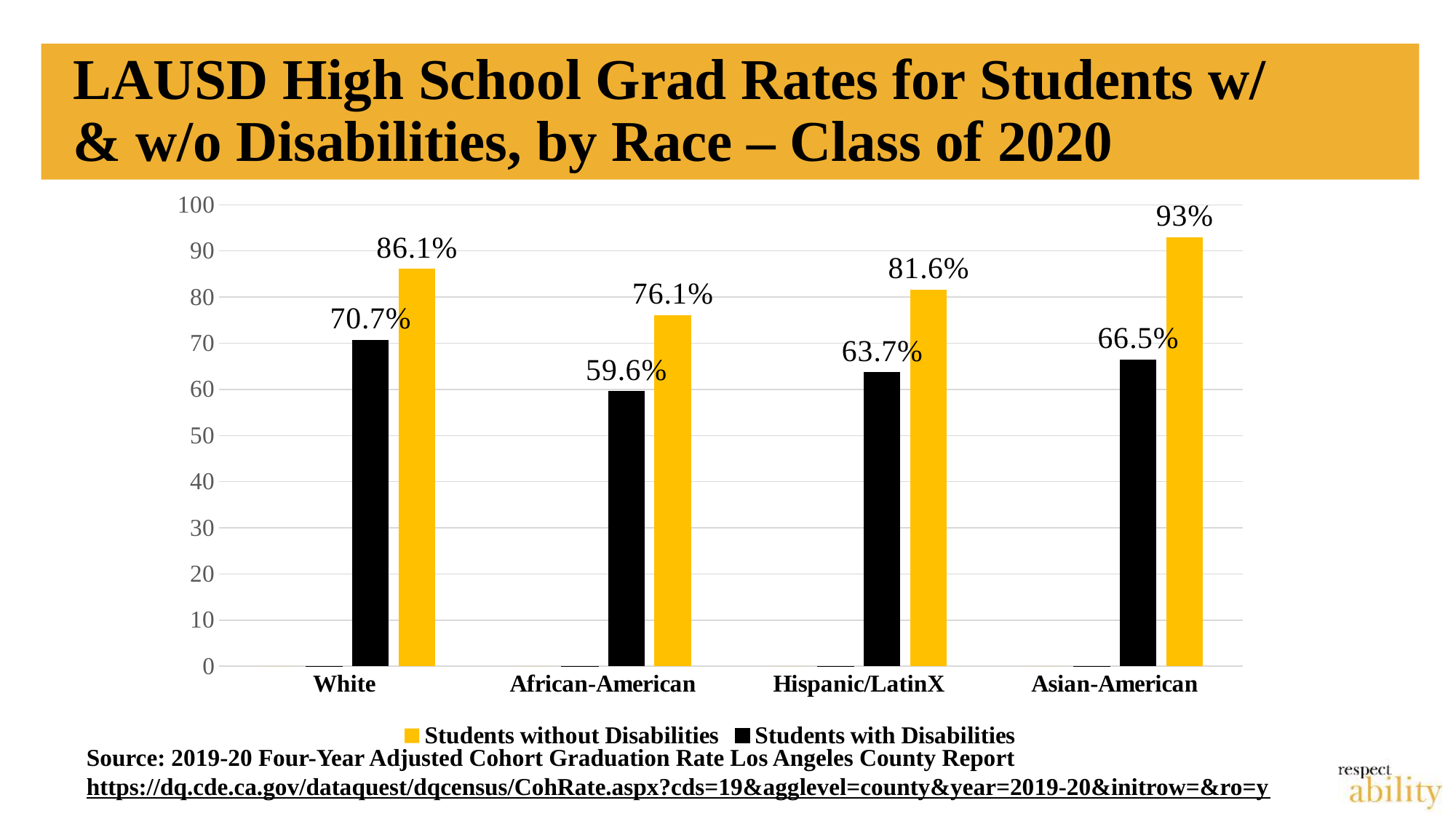
Which race group has the lowest graduation rate for students with disabilities? African-American How many race categories are shown on the x axis? 4 Which race group has the highest graduation rate for students without disabilities? Asian-American What is the graduation rate for Asian-American students without disabilities? 93% What is the graduation rate for White students with disabilities? 70.7% What is the difference between the graduation rates of Asian-American students without disabilities and with disabilities? 26.5% What is the difference between the graduation rates of White students without disabilities and with disabilities? 15.4% Is the graduation rate for African-American students without disabilities greater or less than 80? less Which is larger: the graduation rate for White students with disabilities or for Asian-American students with disabilities? White students with disabilities How many series does the legend list? 2 What kind of chart is shown on the slide? Bar chart What is the graduation rate for Hispanic/LatinX students with disabilities? 63.7%